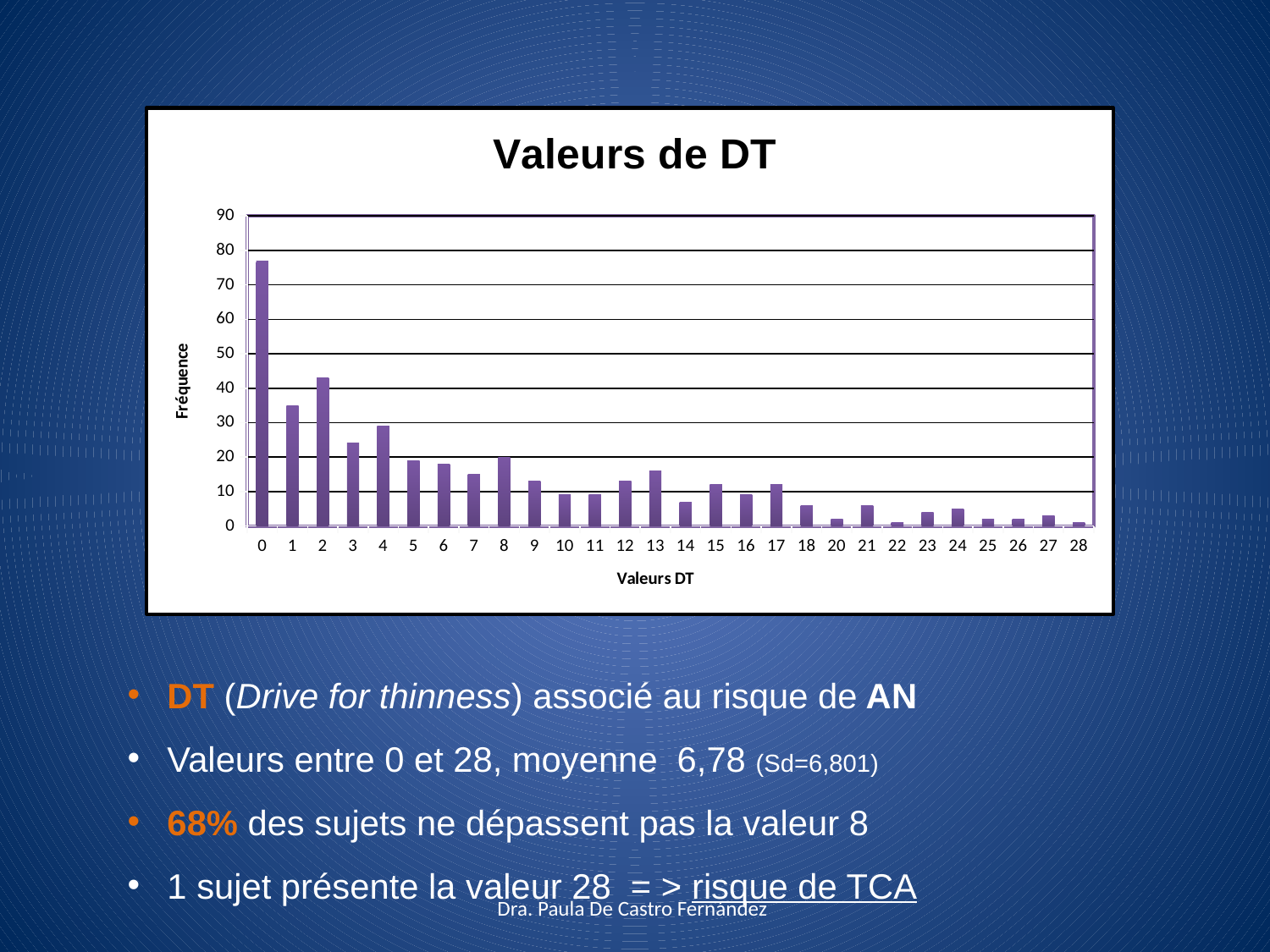
Is the frequency for DT value 3 greater or less than 20? greater Is the frequency for DT value 14 greater or less than 10? less What is the label of the vertical axis? Fréquence Is the frequency for DT value 0 greater or less than 70? greater Which DT value has the highest frequency? 0 Overall, do the frequencies rise or fall as the DT value increases along the x axis? fall Which has a higher frequency, DT value 18 or DT value 20? 18 What kind of chart is shown on the slide? bar chart Which has a higher frequency, DT value 1 or DT value 2? 2 What is the title of the chart? Valeurs de DT